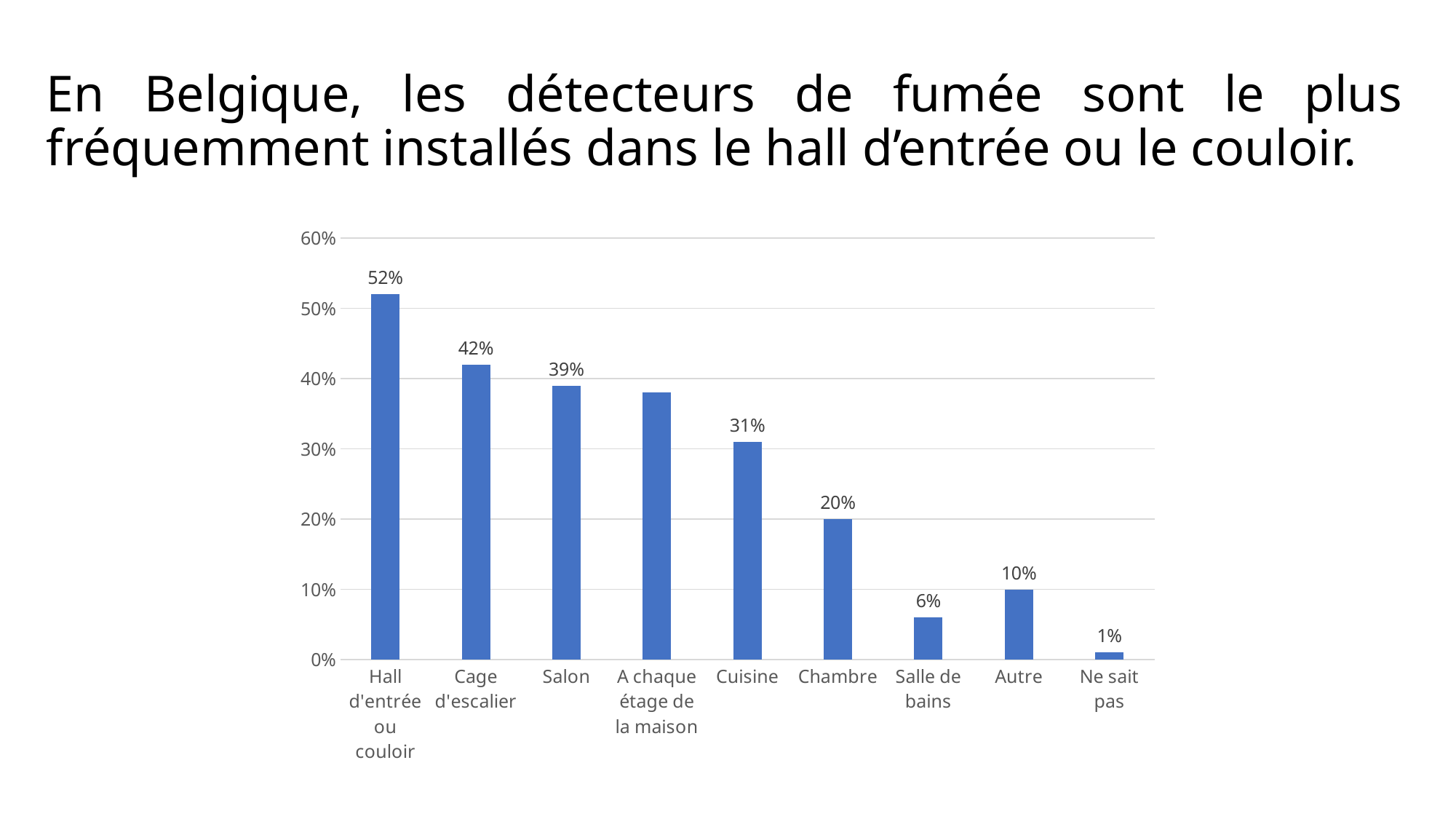
Which category has the highest value? Hall d'entrée ou couloir What kind of chart is shown on the slide? Bar chart What is the highest value shown on the y axis? 60% What percentage is shown for Hall d'entrée ou couloir? 52% What is the difference between the values for Chambre and Autre? 10% What is the difference between the values for Cage d'escalier and Salon? 3% Is the value for A chaque étage de la maison greater or less than 40%? less How many categories are shown on the x axis? 9 Which category has the lowest value? Ne sait pas What is the value for Salle de bains? 6% Which is larger, the value for Autre or the value for Salle de bains? Autre What is the value for Cuisine? 31%